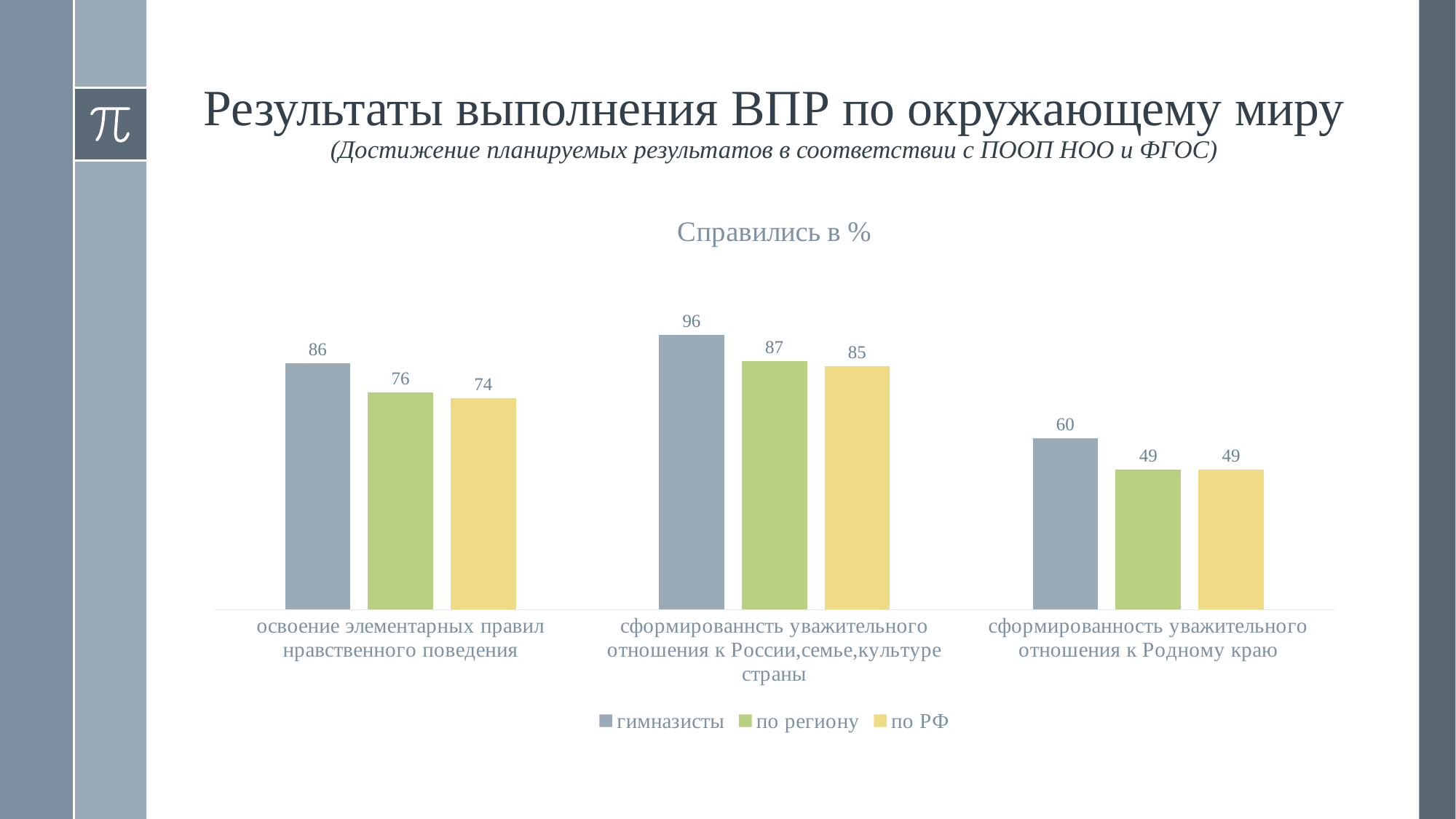
What is the difference between гимназисты and по региону in the category 'сформированность уважительного отношения к Родному краю'? 11 How many series does the legend list? 3 Which category has the highest value for гимназисты? сформированнсть уважительного отношения к России,семье,культуре страны Which is larger in the category 'сформированнсть уважительного отношения к России,семье,культуре страны': по региону or по РФ? по региону What is the value for по региону in the category 'сформированнсть уважительного отношения к России,семье,культуре страны'? 87 What is the value for гимназисты in the category 'освоение элементарных правил нравственного поведения'? 86 What is the difference between гимназисты and по РФ in the category 'освоение элементарных правил нравственного поведения'? 12 What is the value for по РФ in the category 'сформированность уважительного отношения к Родному краю'? 49 What kind of chart is shown on the slide? bar chart What is the title of the chart? Справились в % Which category has the lowest value for по региону? сформированность уважительного отношения к Родному краю How many categories are shown on the x axis? 3